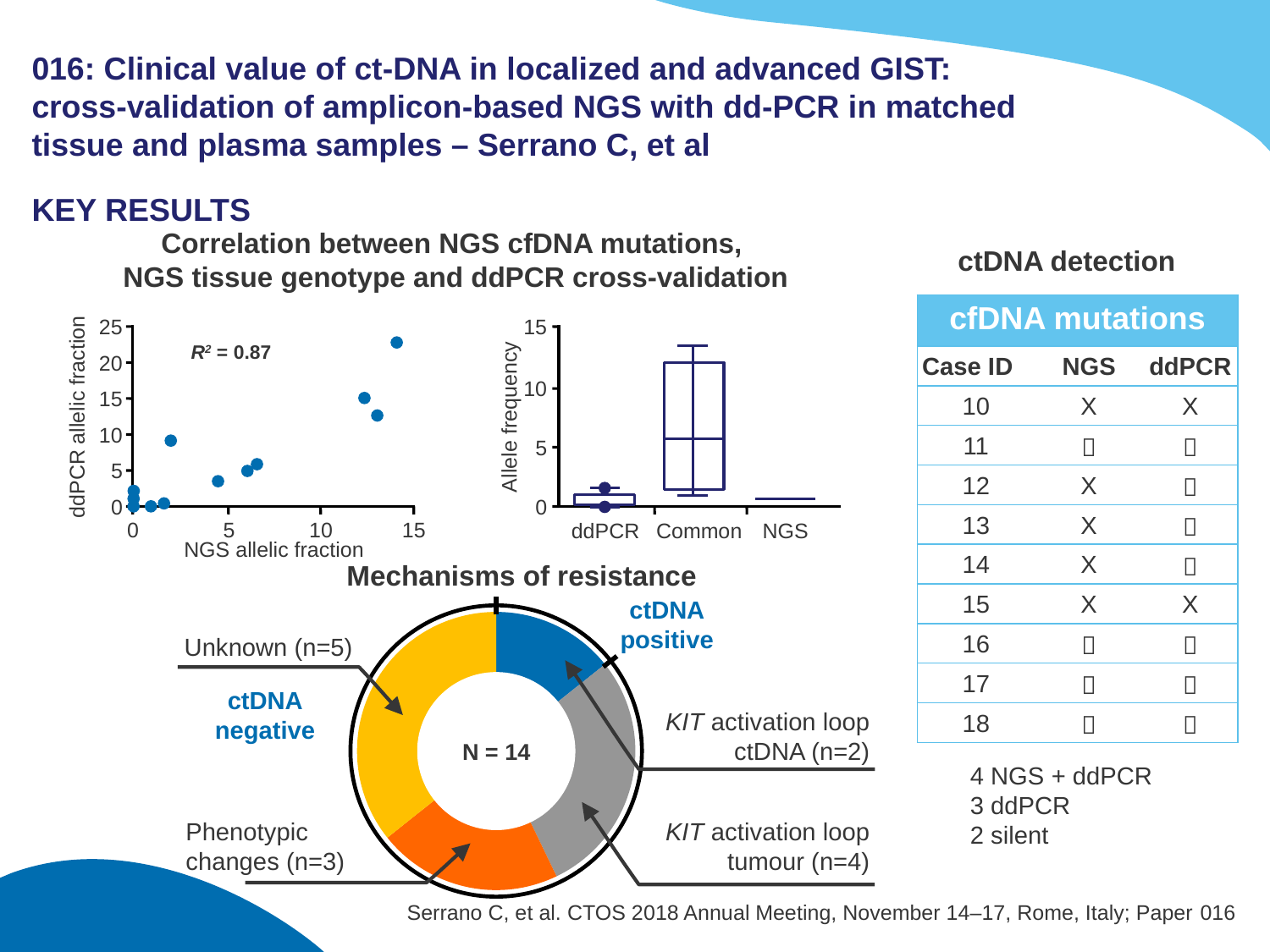
In the Mechanisms of resistance donut chart, how many patients are in the Unknown category? n=5 What kind of chart is the plot of ddPCR allelic fraction against NGS allelic fraction? Scatter plot In the Mechanisms of resistance donut chart, how many patients have KIT activation loop tumour? n=4 How many groups are shown on the x axis of the Allele frequency box plot? 3 In the Allele frequency box plot, which of the three groups has the highest median? Common In the Mechanisms of resistance donut chart, which category has the largest number of patients? Unknown (n=5) In the Mechanisms of resistance donut chart, which category has the smallest number of patients? KIT activation loop ctDNA (n=2) How many categories are shown in the Mechanisms of resistance donut chart? 4 In the scatter plot, is the highest ddPCR allelic fraction value greater or less than 20? greater What is the R² value shown on the scatter plot of NGS allelic fraction versus ddPCR allelic fraction? R² = 0.87 In the Mechanisms of resistance donut chart, what is the total N shown in the centre? N = 14 In the Mechanisms of resistance donut chart, what is the difference between the Unknown count and the Phenotypic changes count? 2